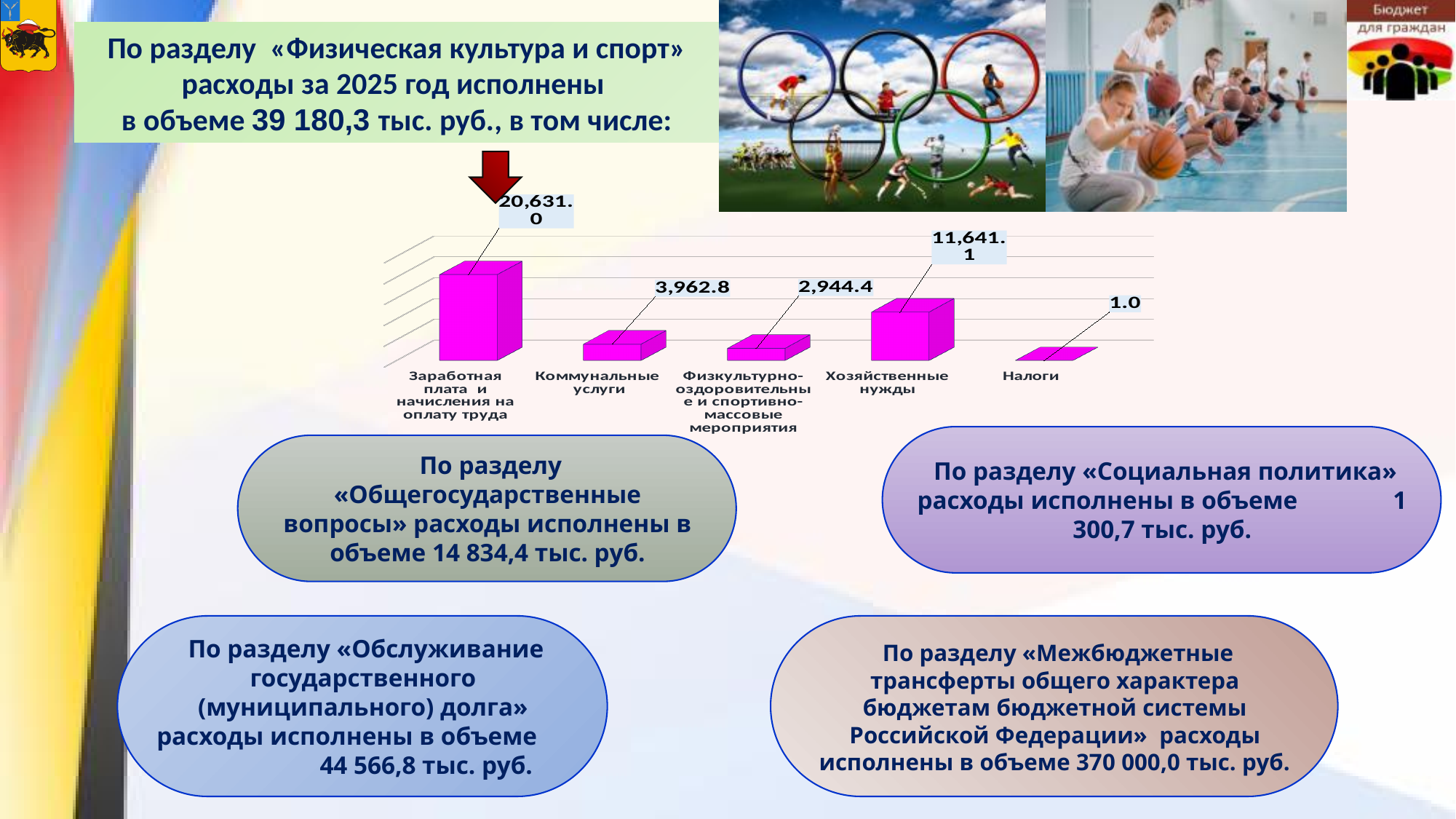
What is the value for «Физкультурно-оздоровительные и спортивно-массовые мероприятия»? 2,944.4 What is the difference between «Коммунальные услуги» and «Физкультурно-оздоровительные и спортивно-массовые мероприятия»? 1,018.4 Which category has the lowest value? Налоги What is the difference between «Заработная плата и начисления на оплату труда» and «Хозяйственные нужды»? 8,989.9 What is the value for «Заработная плата и начисления на оплату труда»? 20,631.0 What is the value for «Хозяйственные нужды»? 11,641.1 Which category has the highest value? Заработная плата и начисления на оплату труда What kind of chart is shown on the slide? Bar chart How many categories are shown in the chart? 5 What is the value for «Коммунальные услуги»? 3,962.8 Which is larger: «Хозяйственные нужды» or «Коммунальные услуги»? Хозяйственные нужды What is the value for «Налоги»? 1.0